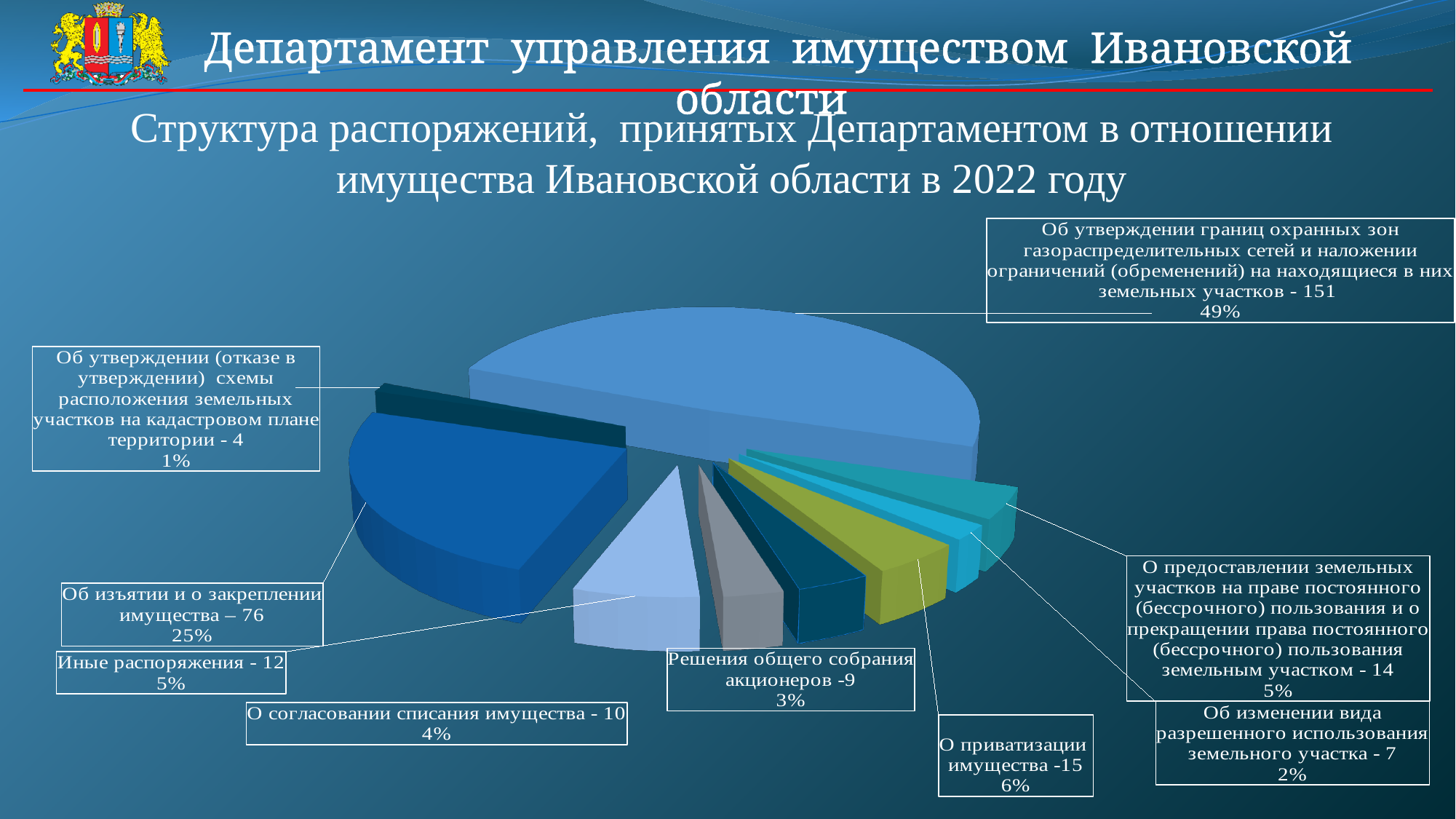
How many categories (slices) does the pie chart have? 9 What is the value for "Об изменении вида разрешенного использования земельного участка"? 7 What is the value for "О приватизации имущества"? 15 How many orders are shown for "Об изъятии и о закреплении имущества"? 76 What is the difference between the number of orders for "Об изъятии и о закреплении имущества" and "О приватизации имущества"? 61 Which category has the smallest slice of the pie? Об утверждении (отказе в утверждении) схемы расположения земельных участков на кадастровом плане территории What share of the pie does "Об утверждении границ охранных зон газораспределительных сетей и наложении ограничений (обременений) на находящиеся в них земельных участков" have? 49% What kind of chart is shown on the slide? pie chart What percentage is shown for "Иные распоряжения"? 5% Which category has the largest slice of the pie? Об утверждении границ охранных зон газораспределительных сетей и наложении ограничений (обременений) на находящиеся в них земельных участков Which is larger: the value for "О согласовании списания имущества" or for "Решения общего собрания акционеров"? О согласовании списания имущества What year does the chart title say the data refers to? 2022